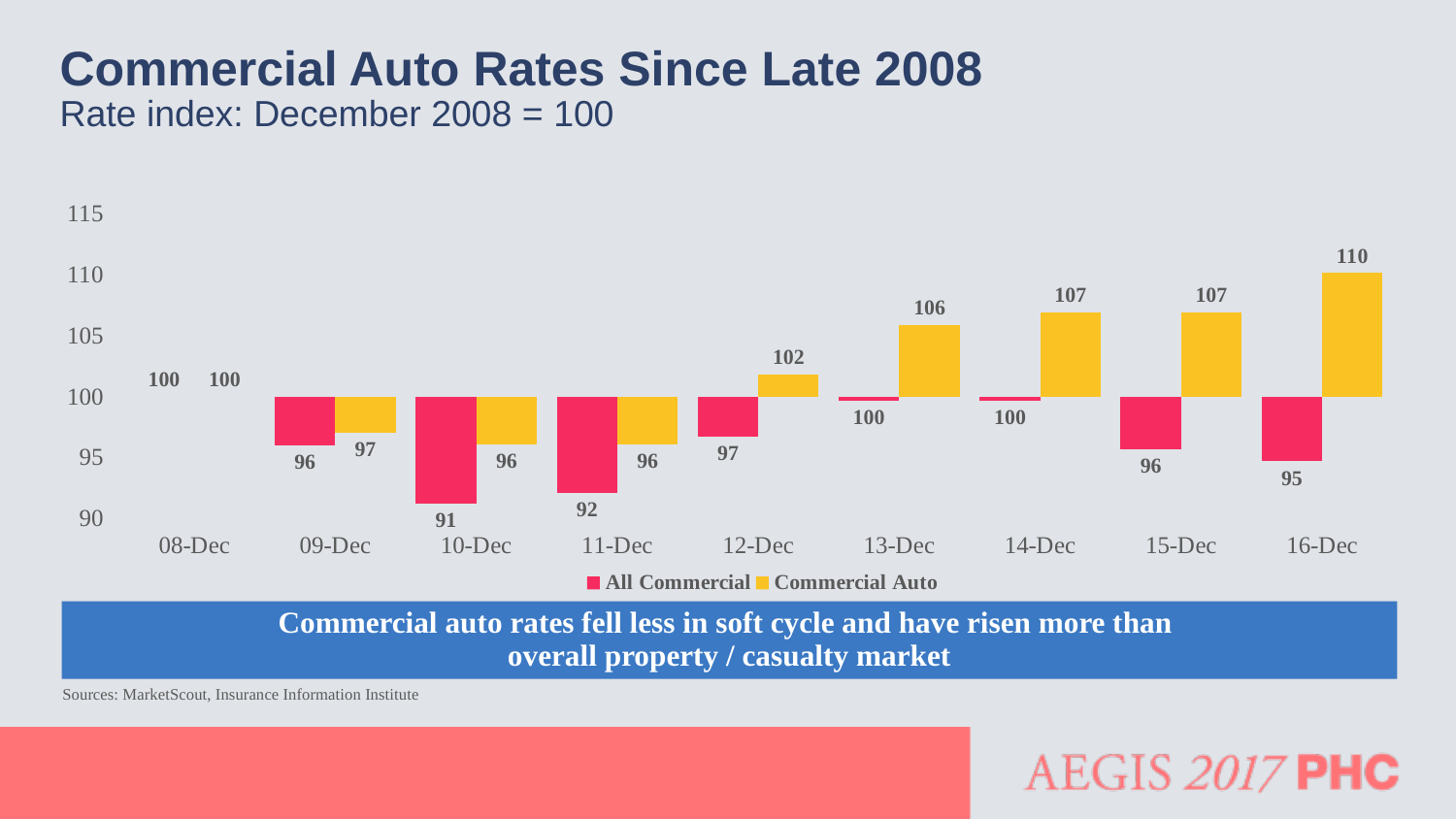
What is the difference between the Commercial Auto and All Commercial values for 16-Dec? 15 Does the Commercial Auto series rise or fall from 12-Dec to 16-Dec? Rise What is the Commercial Auto value for 16-Dec? 110 What is the All Commercial value for 10-Dec? 91 What is the Commercial Auto value for 12-Dec? 102 What kind of chart is shown on the slide? Bar chart Which category has the lowest All Commercial value? 10-Dec What is the All Commercial value for 15-Dec? 96 Which category has the highest Commercial Auto value? 16-Dec How many series does the legend list? 2 How many categories are shown on the x axis? 9 Which is larger for 13-Dec, the All Commercial value or the Commercial Auto value? Commercial Auto